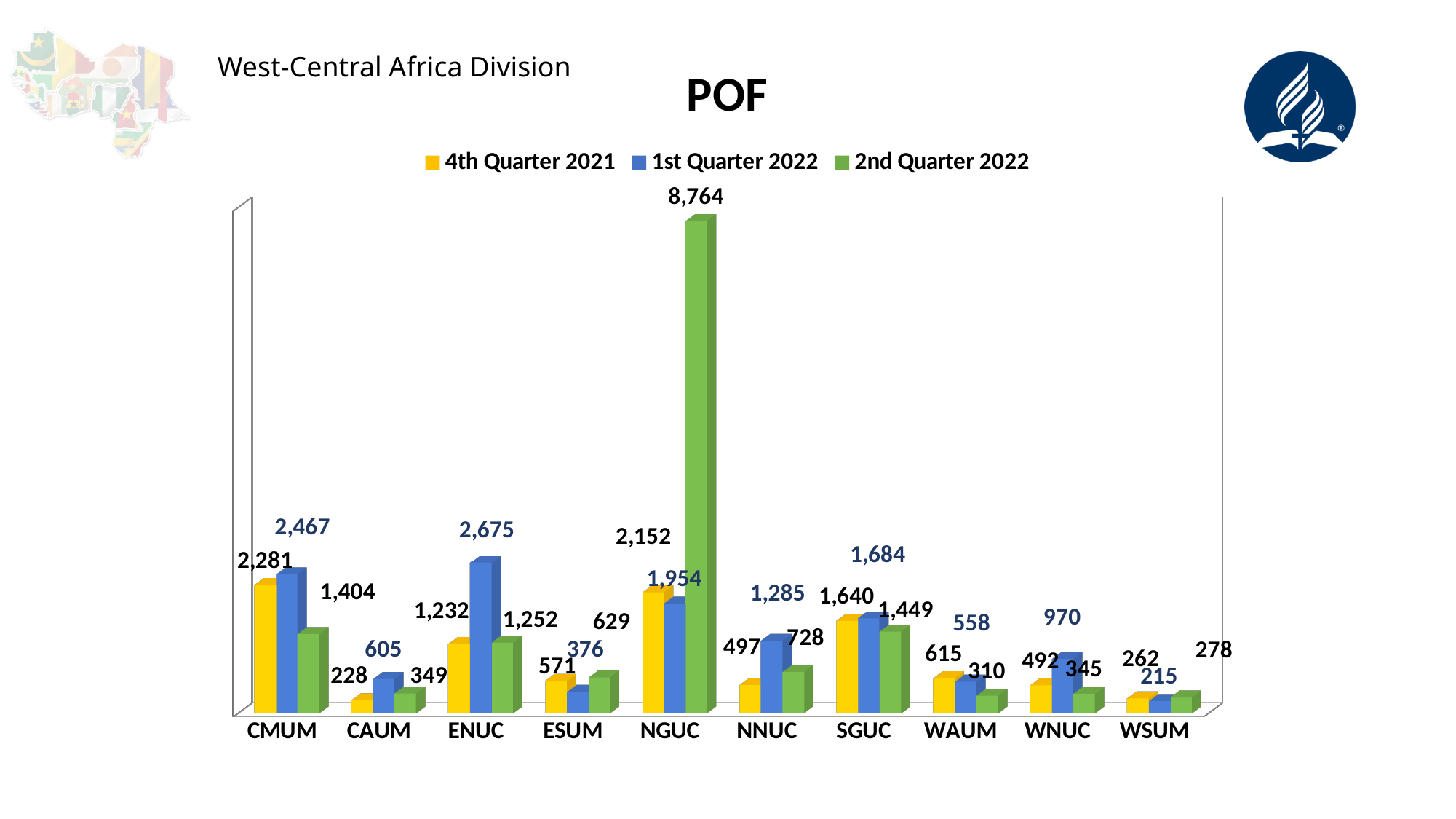
What kind of chart is shown on the slide? Bar chart What is the title of the chart? POF What is the value for WAUM in the 4th Quarter 2021 series? 615 Which is larger for NNUC: the 4th Quarter 2021 value or the 2nd Quarter 2022 value? 2nd Quarter 2022 Which category has the highest value in the 2nd Quarter 2022 series? NGUC What is the value for NGUC in the 2nd Quarter 2022 series? 8,764 How many categories are shown on the x axis? 10 Which category has the lowest value in the 1st Quarter 2022 series? WSUM What is the value for ENUC in the 1st Quarter 2022 series? 2,675 What is the difference between the 1st Quarter 2022 and 4th Quarter 2021 values for CMUM? 186 How many series does the legend list? 3 What is the value for CAUM in the 2nd Quarter 2022 series? 349